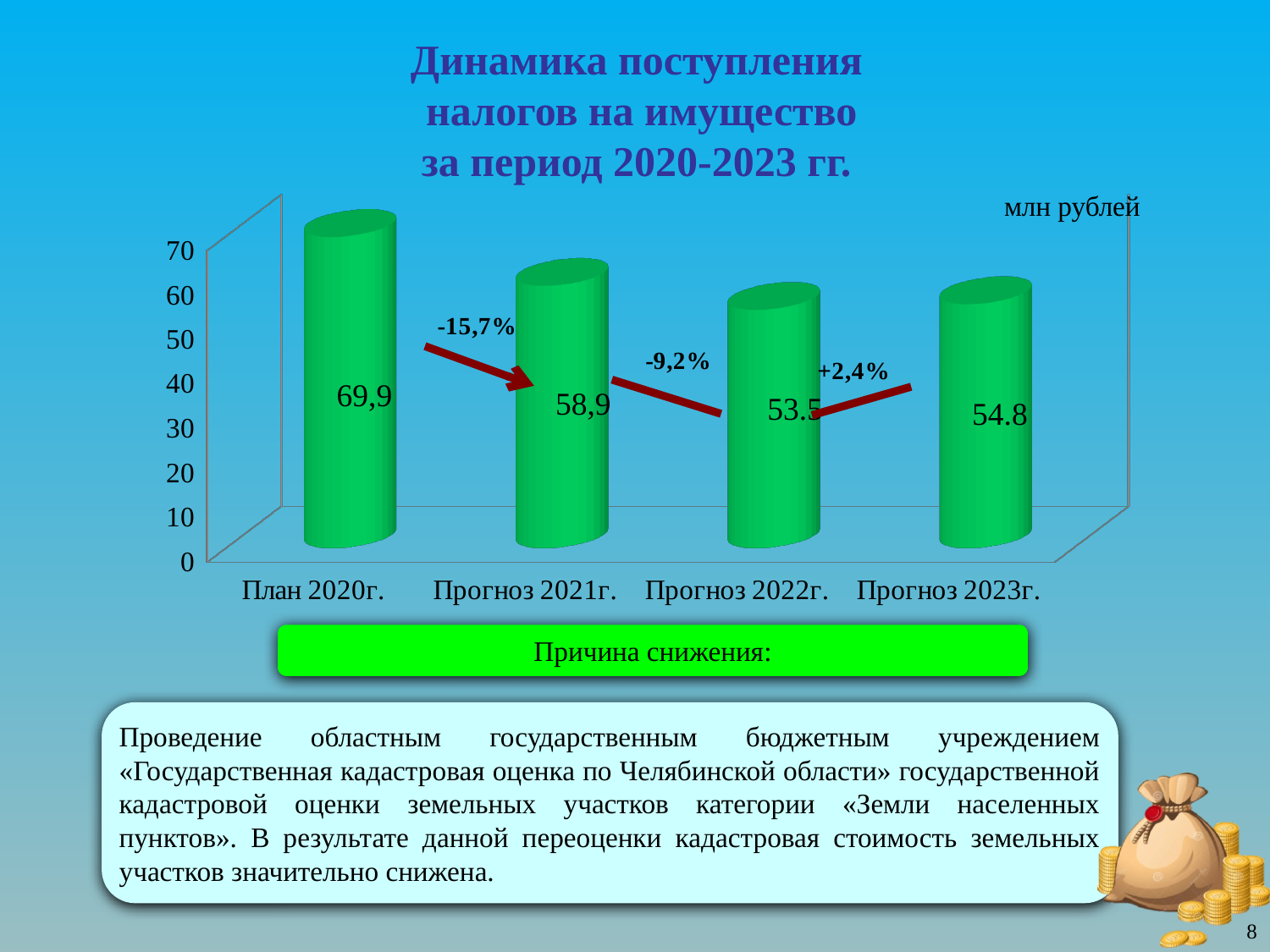
Which is larger, the value for Прогноз 2022г. or Прогноз 2023г.? Прогноз 2023г. What unit is indicated for the chart values? млн рублей What is the value for План 2020г.? 69,9 Which category has the lowest value? Прогноз 2022г. What kind of chart is shown on the slide? bar chart What is the value for Прогноз 2023г.? 54.8 What percentage change is labelled between План 2020г. and Прогноз 2021г.? -15,7% Which category has the highest value? План 2020г. Is the value for Прогноз 2022г. greater or less than 60? less What is the difference between the values for План 2020г. and Прогноз 2021г.? 11 How many categories are shown on the x axis? 4 What is the value for Прогноз 2021г.? 58,9